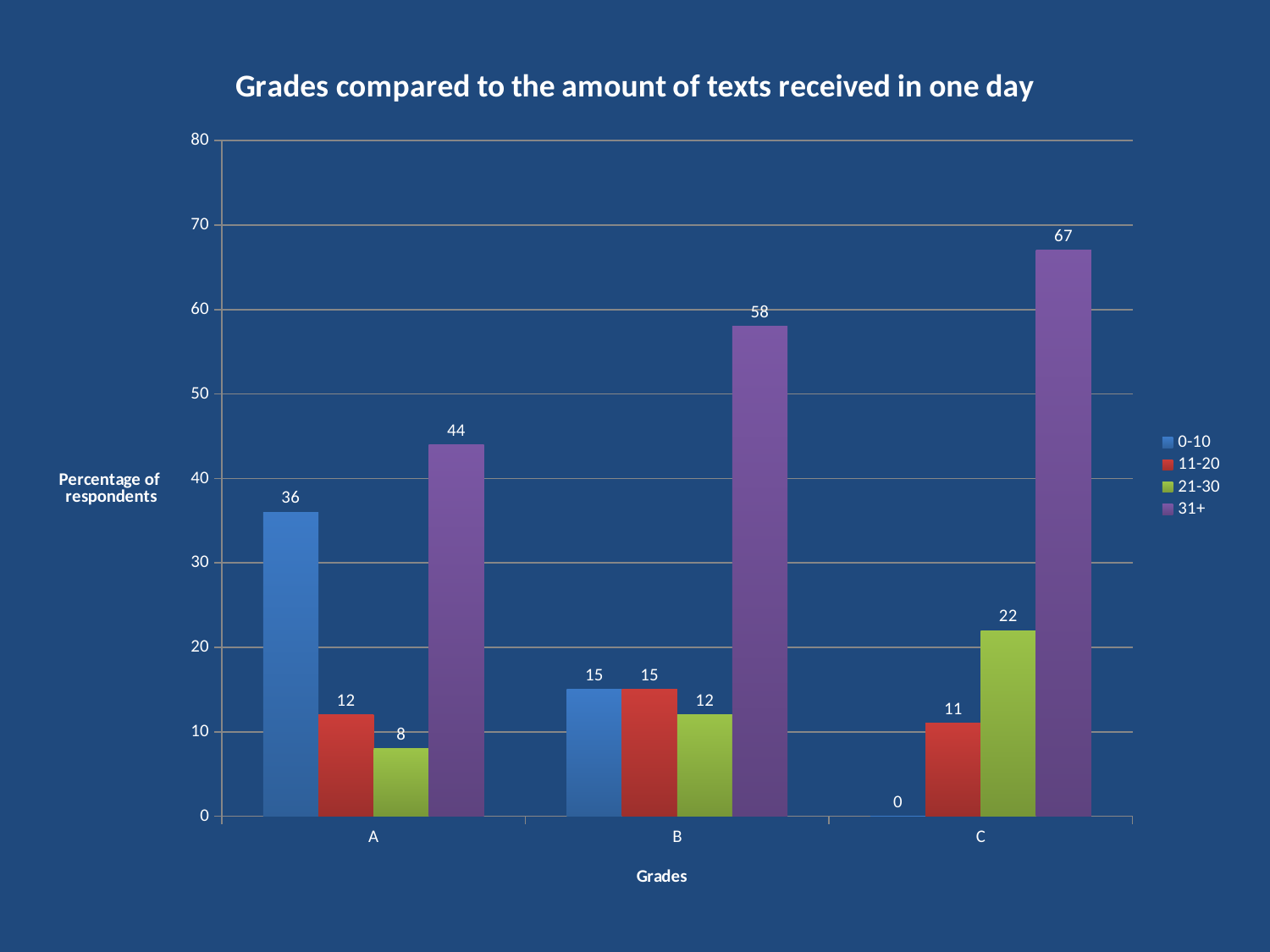
What is the difference between the 31+ values for grade C and grade A? 23 Which grade has the lowest value for the 0-10 series? C Which is larger: the 21-30 value at grade C or the 11-20 value at grade C? 21-30 value at grade C Is the value for the 31+ series at grade B greater or less than 50? greater What kind of chart is shown on the slide? bar chart Which grade has the highest value for the 31+ series? C How many series does the legend list? 4 How many grade categories are shown on the x axis? 3 What is the value for the 31+ series at grade C? 67 What is the value for the 0-10 series at grade A? 36 What is the title of the chart? Grades compared to the amount of texts received in one day What is the value for the 21-30 series at grade B? 12